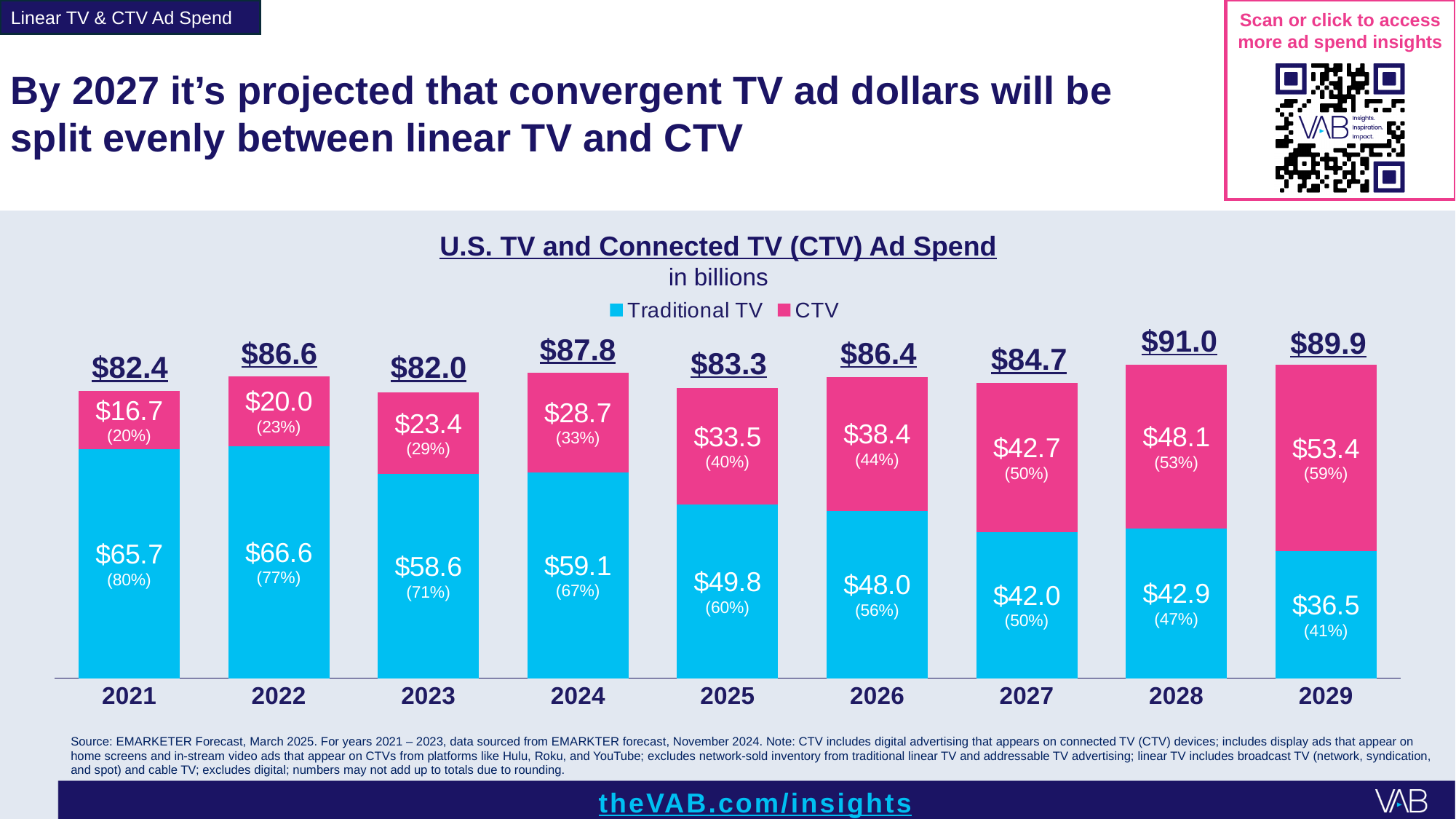
What is the total ad spend shown for 2028? $91.0 What kind of chart is shown? Stacked bar chart Does the CTV value rise or fall from 2021 to 2029? Rise What is the difference between the CTV value in 2029 and the CTV value in 2021? $36.7 Which is larger in 2026, Traditional TV or CTV? Traditional TV How many series does the legend list? 2 Which year has the lowest total ad spend? 2023 What is the Traditional TV ad spend value for 2021? $65.7 How many years are shown on the x axis? 9 Which year has the highest total ad spend? 2028 What is the CTV ad spend value for 2029? $53.4 What percentage share of the 2027 total does CTV represent? 50%